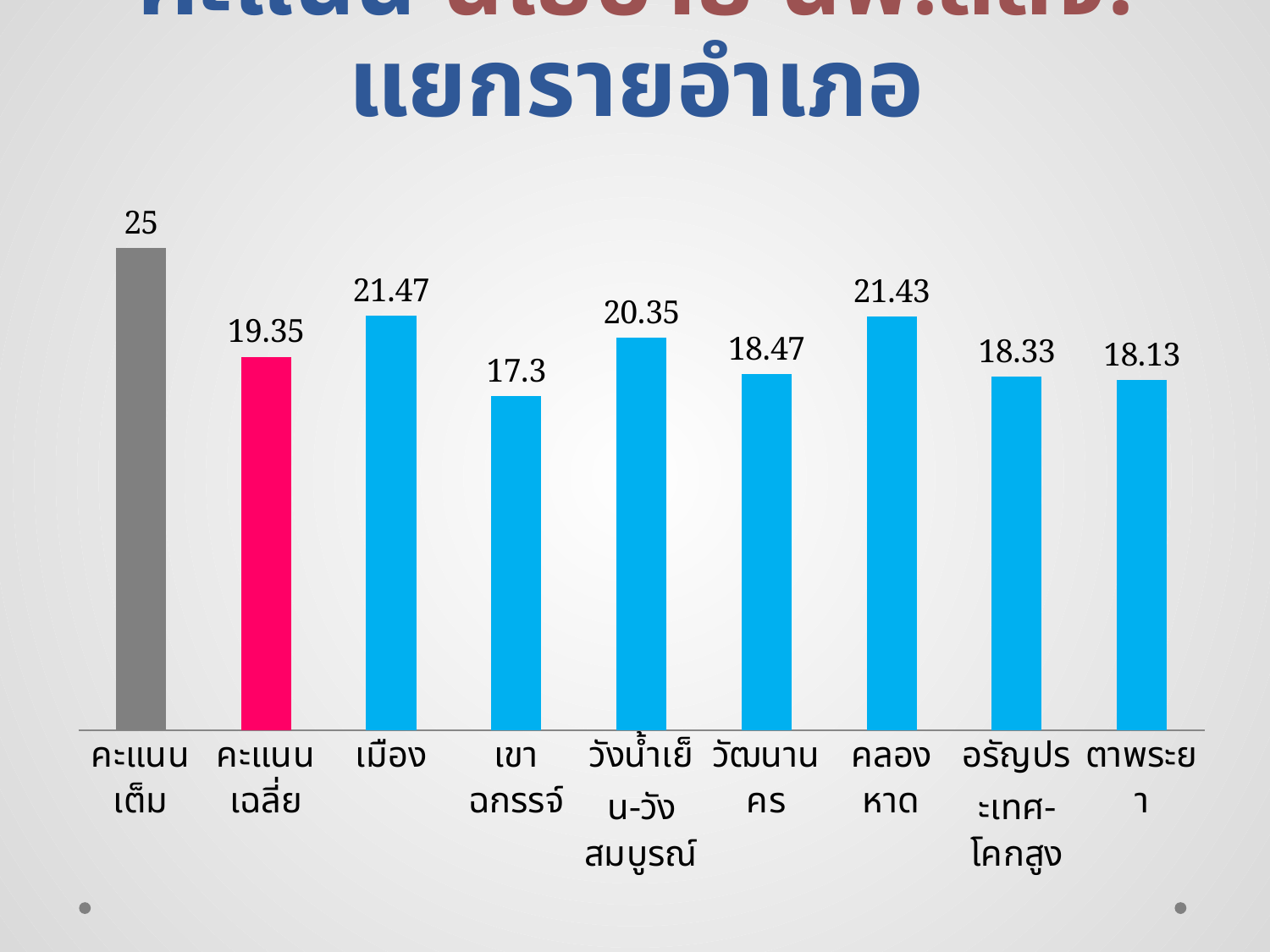
What is the value shown for คลองหาด? 21.43 Which category has the highest value in the chart? คะแนนเต็ม What is the value shown for เขาฉกรรจ์? 17.3 How many bars are shown in the chart? 9 Which category has the lowest value in the chart? เขาฉกรรจ์ What is the value shown for คะแนนเฉลี่ย? 19.35 What is the value shown for เมือง? 21.47 Which has a larger value, วังน้ำเย็น-วังสมบูรณ์ or ตาพระยา? วังน้ำเย็น-วังสมบูรณ์ What kind of chart is shown on the slide? Bar chart What is the difference between the values for คะแนนเต็ม and คะแนนเฉลี่ย? 5.65 What is the value shown for ตาพระยา? 18.13 What is the value shown for คะแนนเต็ม? 25